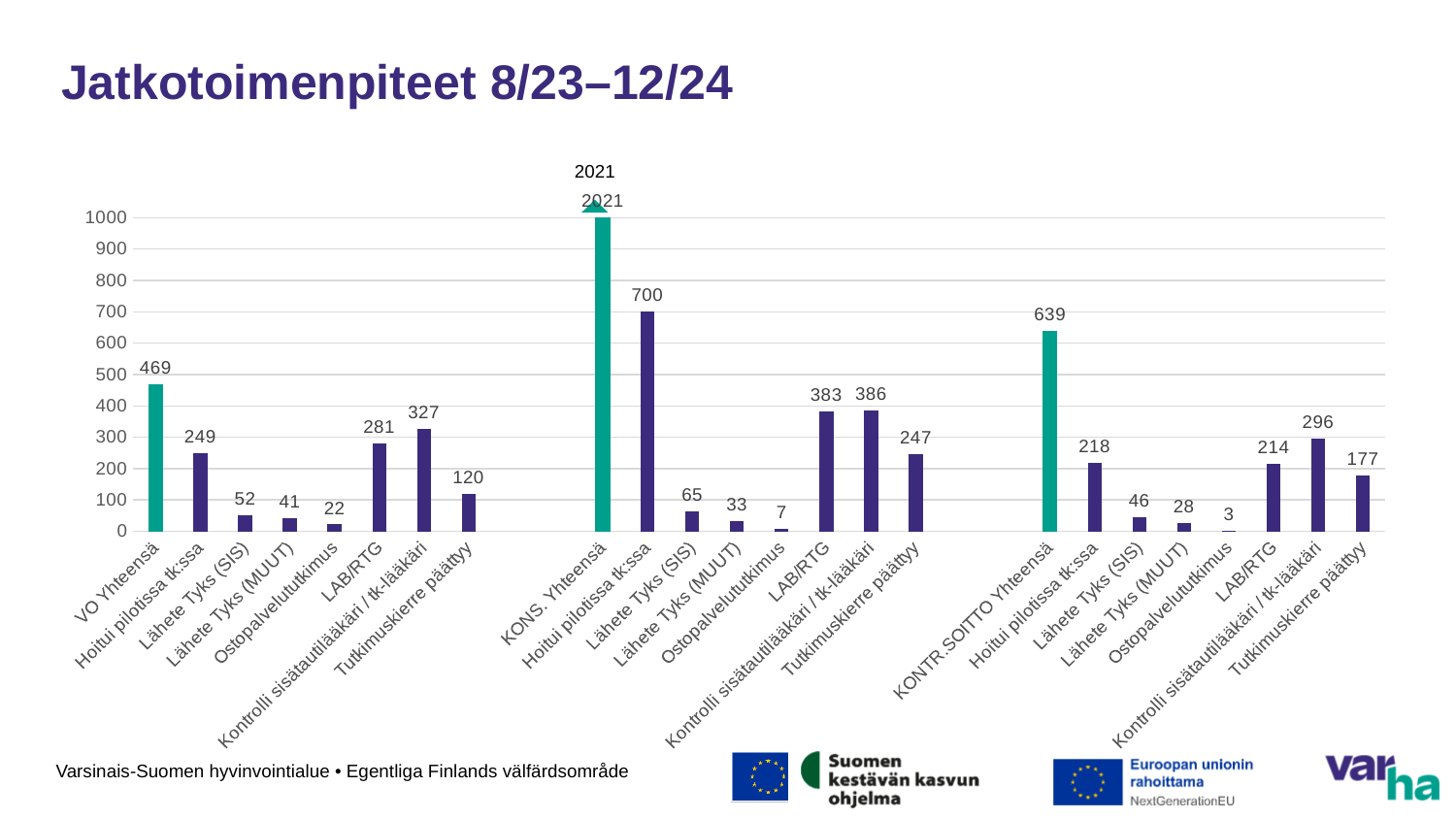
What is the title of the slide? Jatkotoimenpiteet 8/23–12/24 In the KONS. group, what is the value for Hoitui pilotissa tk:ssa? 700 What type of chart is shown on the slide? Bar chart What is the value for KONTR.SOITTO Yhteensä? 639 What is the value for KONS. Yhteensä? 2021 What is the difference between KONS. Yhteensä and KONTR.SOITTO Yhteensä? 1382 Which bar has the highest value on the chart? KONS. Yhteensä What is the difference between Kontrolli sisätautilääkäri / tk-lääkäri and LAB/RTG in the VO group? 46 In the KONTR.SOITTO group, what is the value for Tutkimuskierre päättyy? 177 Which is larger: LAB/RTG in the VO group or LAB/RTG in the KONS. group? LAB/RTG in the KONS. group Which bar has the lowest value on the chart? Ostopalvelututkimus in the KONTR.SOITTO group (3) What is the value for VO Yhteensä? 469